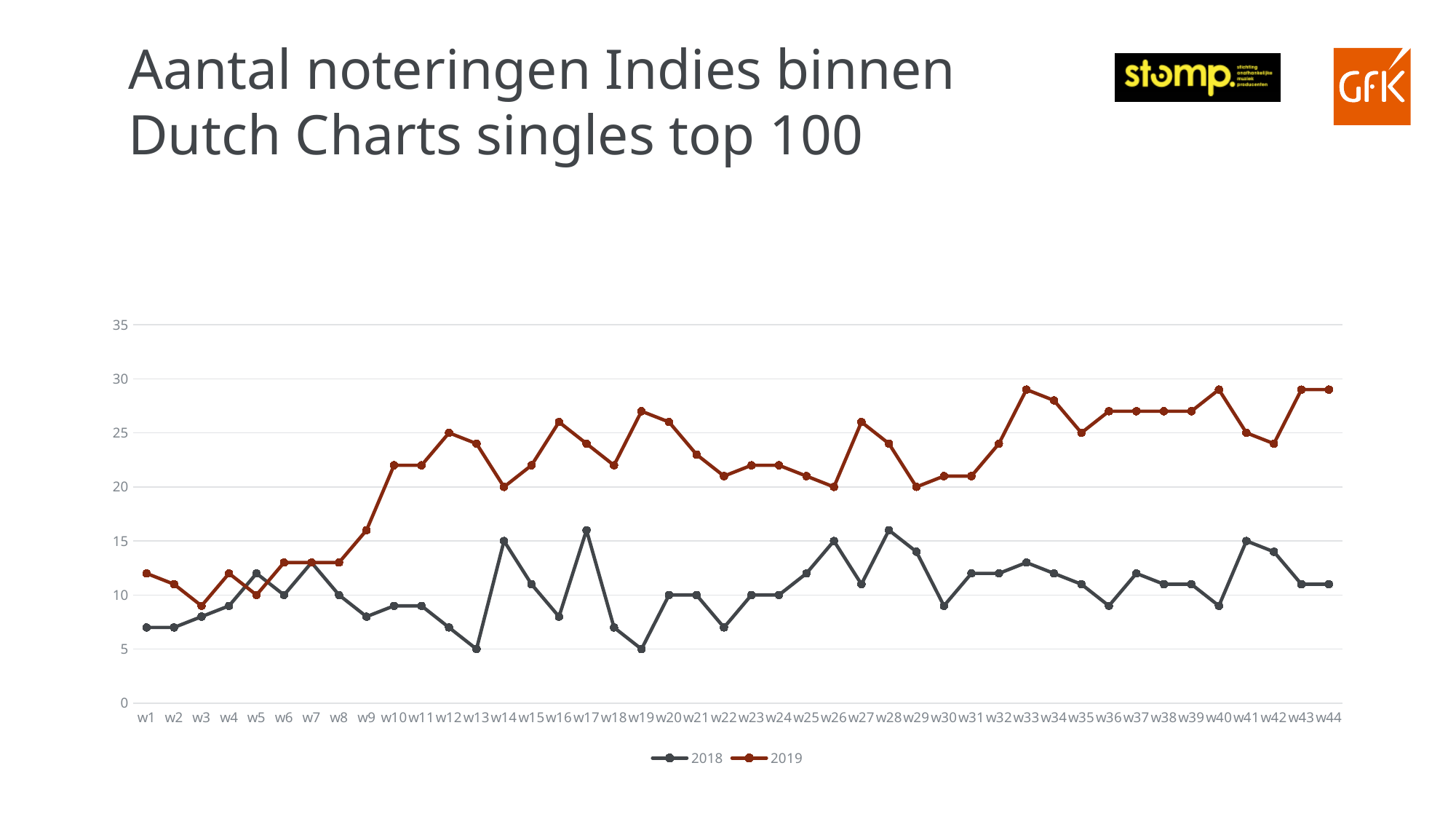
How many series does the legend list? 2 Is the value for 2019 at w33 greater or less than 25? greater Which two series are listed in the legend? 2018 and 2019 Is the value for 2018 at w1 greater or less than 10? less How many weeks are plotted along the x axis? 44 At w44, which series has the higher value, 2018 or 2019? 2019 Is the value for 2019 at w10 greater or less than 20? greater What is the title of the chart on the slide? Aantal noteringen Indies binnen Dutch Charts singles top 100 Does the 2019 series overall rise or fall from w1 to w44? rise What kind of chart is shown on the slide? line chart At w5, which series has the higher value, 2018 or 2019? 2018 What is the value for 2018 at w13? 5